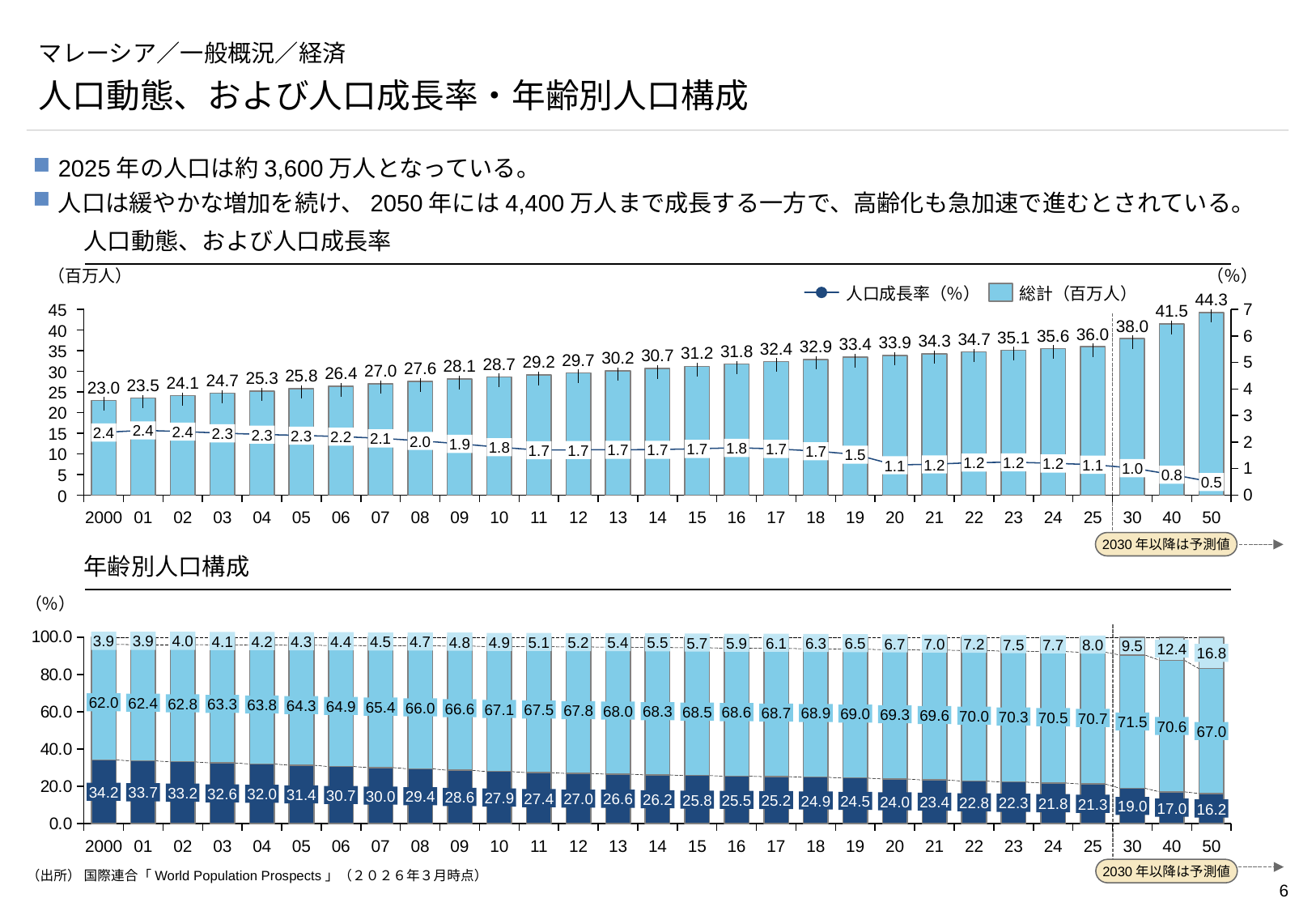
In the bottom chart (年齢別人口構成), what is the value of the bottom (dark blue) segment for 2000? 34.2 What kind of chart is the bottom chart (年齢別人口構成)? stacked bar chart In the top chart (人口動態、および人口成長率), which year has the highest total population (総計)? 50 In the bottom chart (年齢別人口構成), what is the difference between the top segment values for 50 and 2000? 12.9 In the top chart (人口動態、および人口成長率), what is the population growth rate (人口成長率) for 2000? 2.4 In the top chart (人口動態、および人口成長率), what is the total population (総計) value for 2000? 23.0 In the top chart (人口動態、および人口成長率), what is the difference in total population (総計) between 25 and 2000? 13.0 In the bottom chart (年齢別人口構成), what is the value of the top segment for 50 (2050)? 16.8 In the top chart (人口動態、および人口成長率), what is the total population (総計) value for 50 (2050)? 44.3 In the top chart (人口動態、および人口成長率), how many series does the legend list? 2 In the top chart (人口動態、および人口成長率), what is the population growth rate (人口成長率) for 50 (2050)? 0.5 In the top chart (人口動態、および人口成長率), does the population growth rate (人口成長率) rise or fall from 2000 to 50? fall